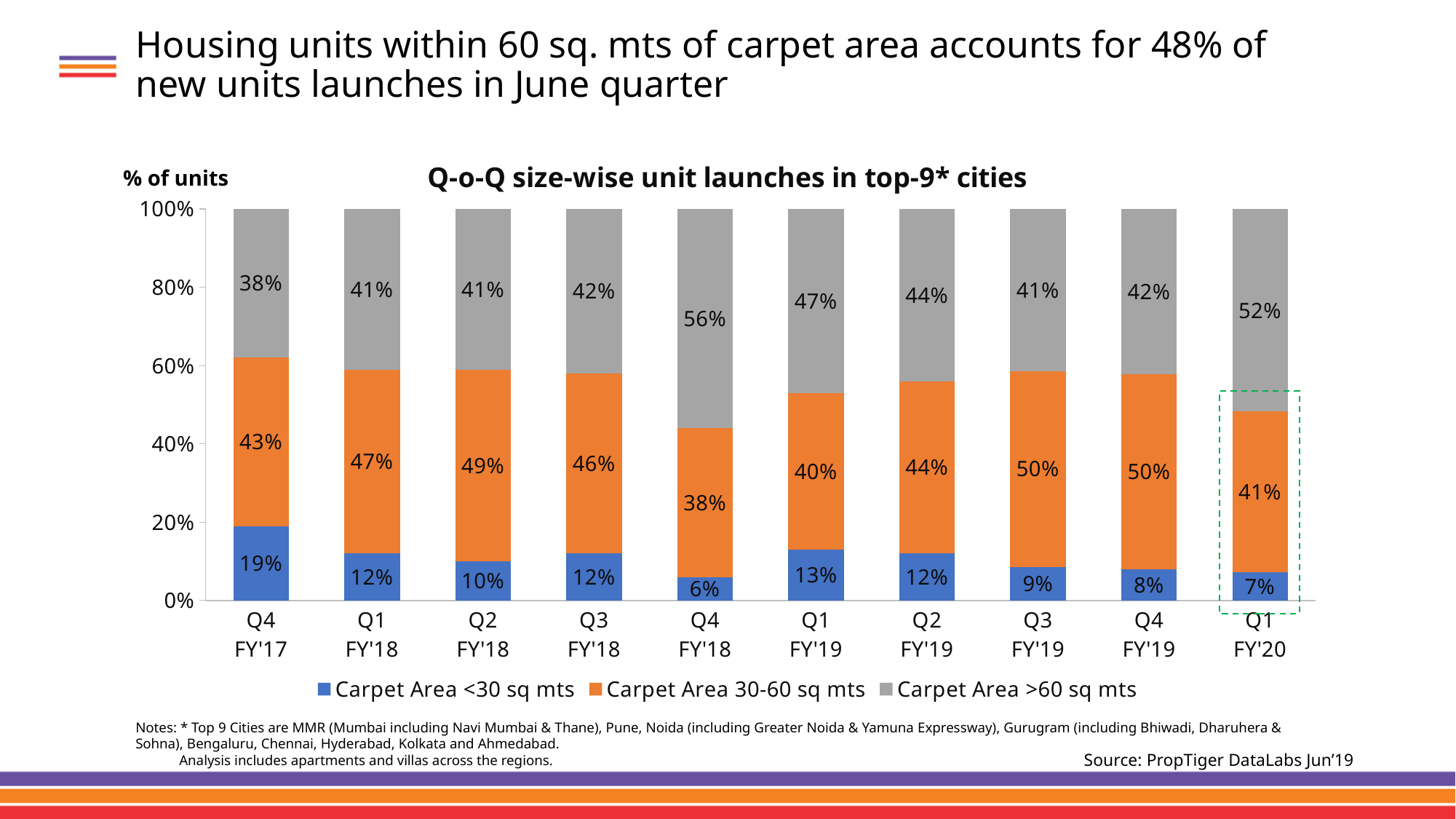
What is the value for Carpet Area 30-60 sq mts in Q1 FY'20? 41% What is the title of the chart? Q-o-Q size-wise unit launches in top-9* cities What is the combined total of Carpet Area <30 sq mts and Carpet Area 30-60 sq mts in Q1 FY'20? 48% What kind of chart is shown on the slide? Stacked bar chart What is the value for Carpet Area <30 sq mts in Q4 FY'17? 19% What is the value for Carpet Area >60 sq mts in Q4 FY'18? 56% What is the difference between the Carpet Area 30-60 sq mts values in Q3 FY'19 and Q1 FY'20? 9% How many series does the legend list? 3 Which is larger in Q1 FY'19: Carpet Area 30-60 sq mts or Carpet Area >60 sq mts? Carpet Area >60 sq mts How many quarters are shown on the x axis? 10 In which quarter is the Carpet Area >60 sq mts share the highest? Q4 FY'18 In which quarter is the Carpet Area <30 sq mts share the lowest? Q4 FY'18